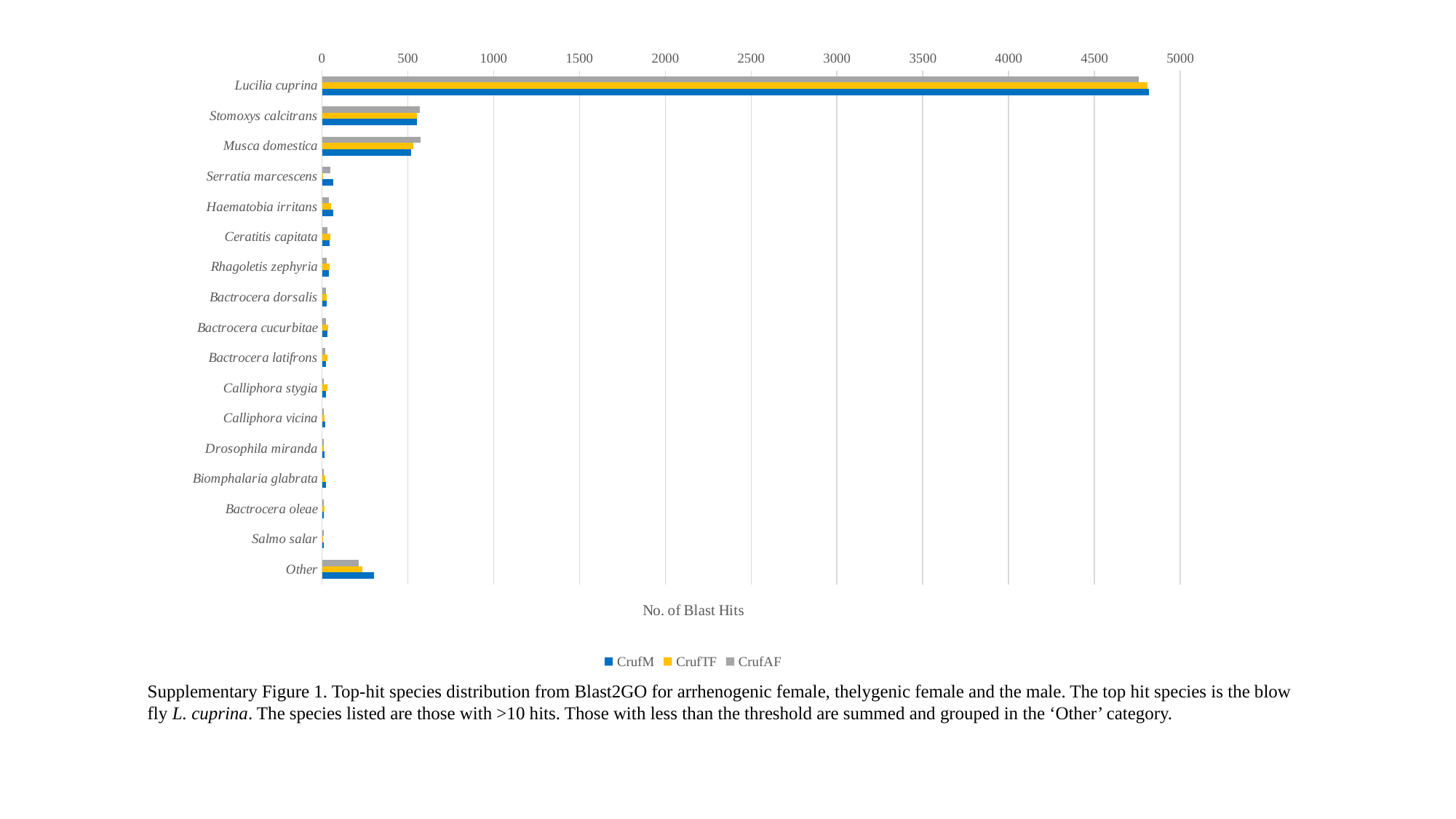
Is the CrufM value for Serratia marcescens greater or less than 500? less Is the CrufM value for Other greater or less than 500? less What is the label of the horizontal axis? No. of Blast Hits Is the CrufM value for Lucilia cuprina greater or less than 4500? greater Which has more Blast hits for CrufM, Lucilia cuprina or Stomoxys calcitrans? Lucilia cuprina Which category has the highest number of Blast hits? Lucilia cuprina What kind of chart is shown on the slide? bar chart Which series is shown in blue in the legend? CrufM Which has more Blast hits for CrufM, Other or Serratia marcescens? Other How many series does the legend list? 3 How many categories are plotted on the y axis? 17